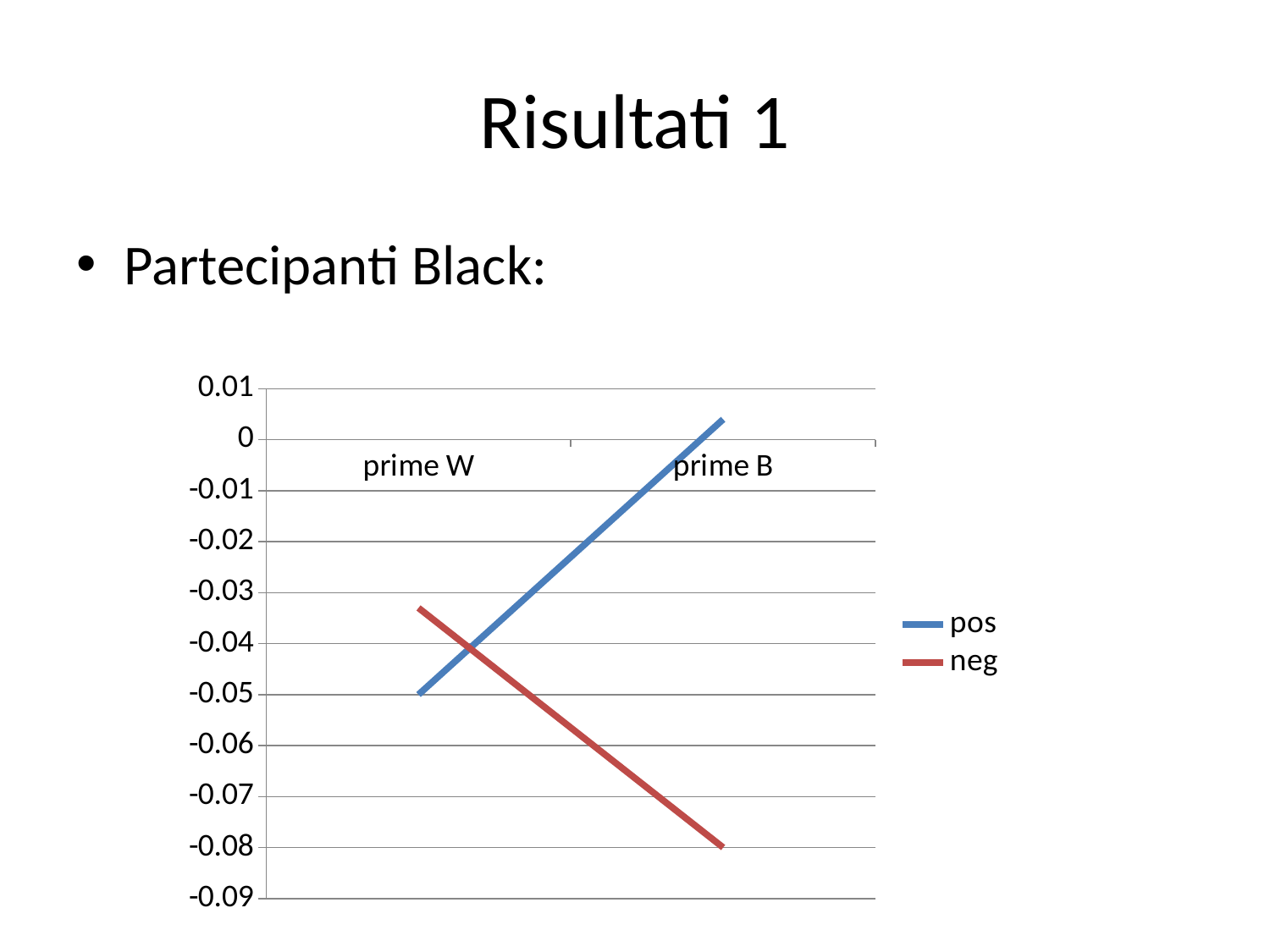
How many categories are shown on the x axis? 2 What colour is the line for the neg series? red What is the value of the neg series at prime B? -0.08 At prime B, which series has the higher value, pos or neg? pos Does the neg series rise or fall from prime W to prime B? fall What kind of chart is shown on the slide? line chart Is the value of the pos series at prime B greater or less than 0? greater Does the pos series rise or fall from prime W to prime B? rise How many series does the legend list? 2 What is the value of the pos series at prime W? -0.05 Is the value of the neg series at prime W greater or less than -0.04? greater What are the two series named in the legend? pos and neg